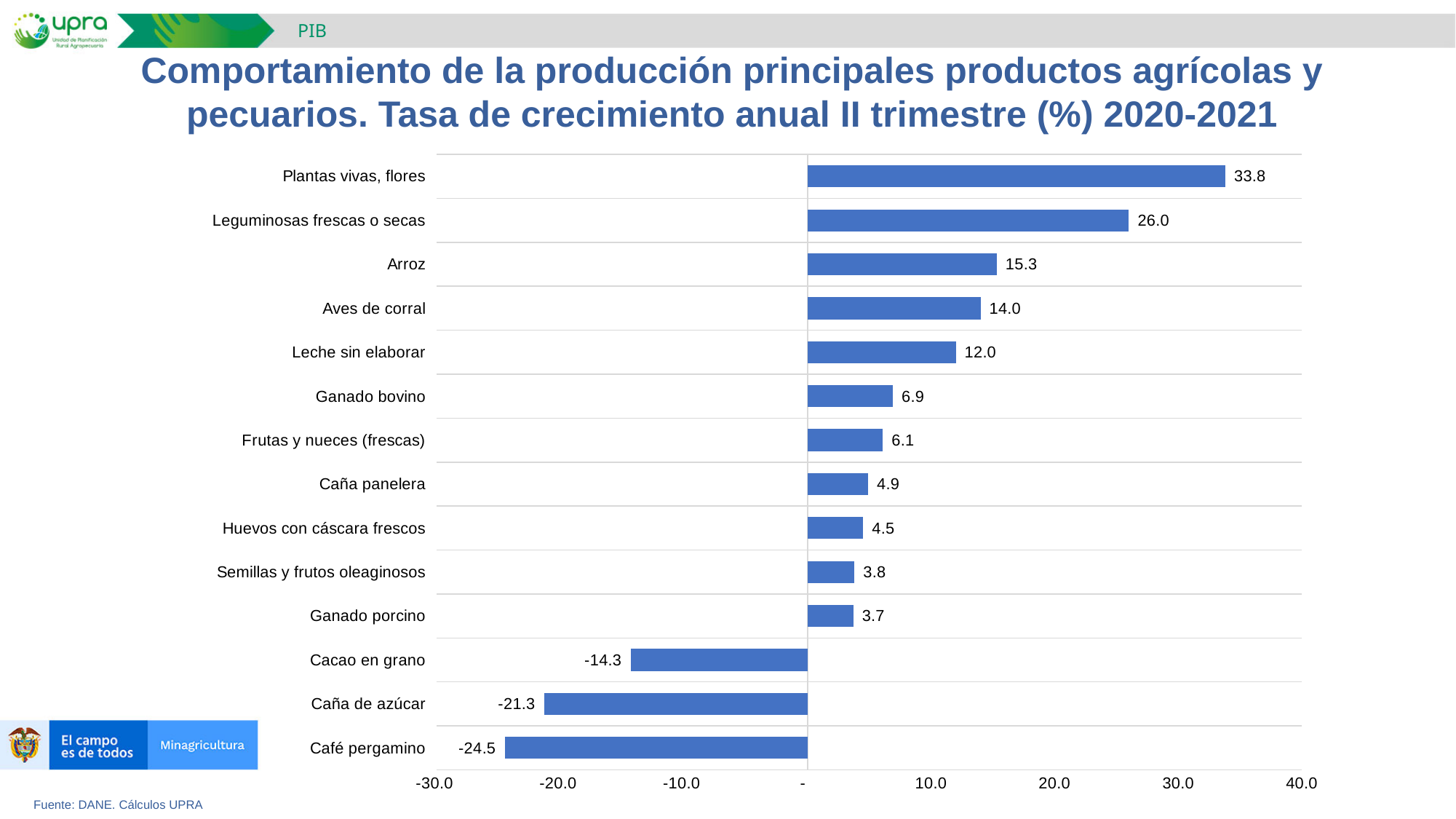
Which category has the lowest value? Café pergamino What is the value for Arroz? 15.3 What kind of chart is shown on the slide? Bar chart Which is larger, the value for Aves de corral or the value for Ganado bovino? Aves de corral How many categories have negative values? 3 What is the source cited below the chart? Fuente: DANE. Cálculos UPRA Which category has the highest value? Plantas vivas, flores What is the value for Leche sin elaborar? 12.0 What is the value for Café pergamino? -24.5 What is the difference between the values for Plantas vivas, flores and Leguminosas frescas o secas? 7.8 Is the value for Leguminosas frescas o secas greater or less than 20.0? greater How many categories are shown in the chart? 14